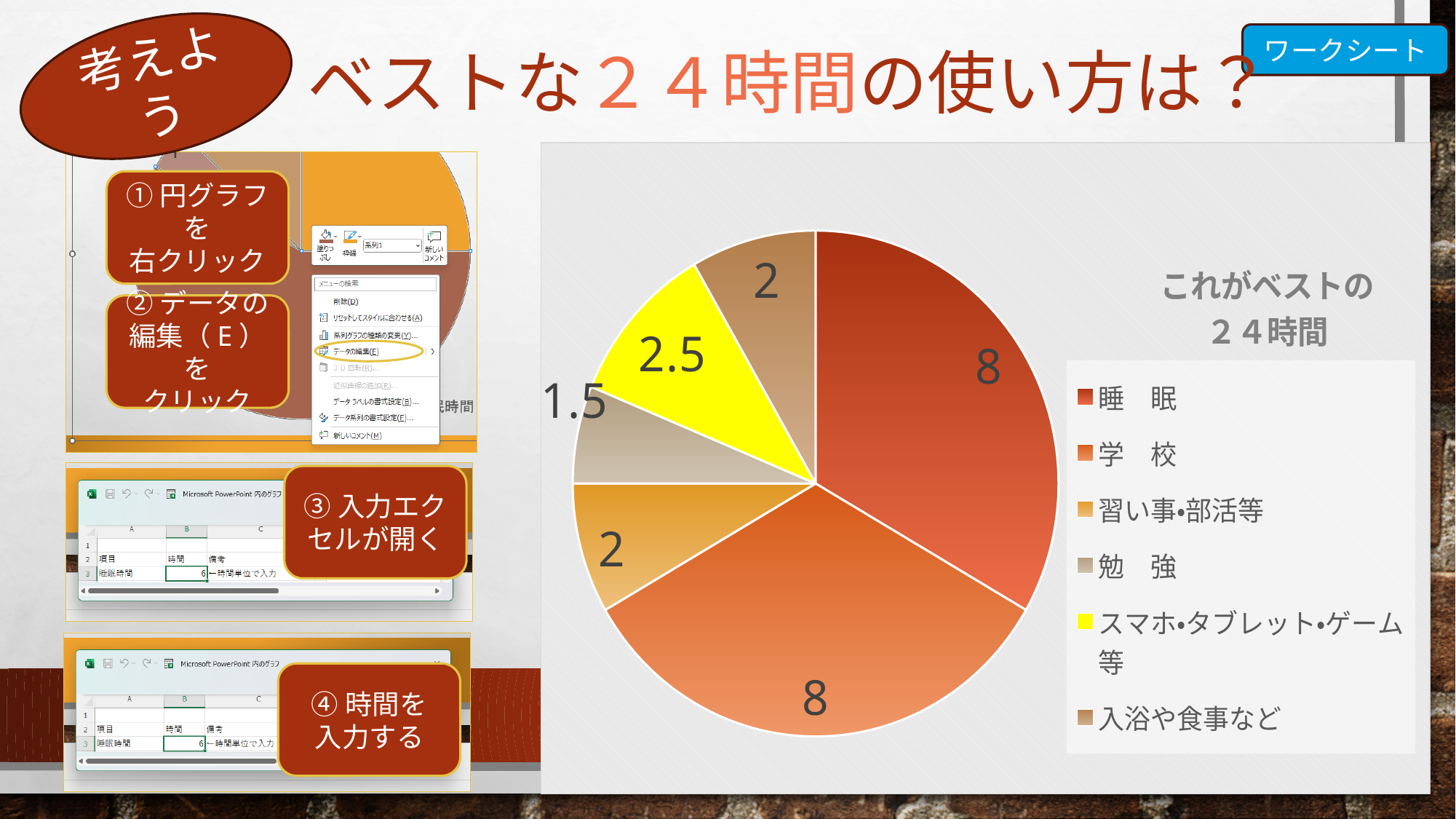
What is the total of all the values shown in the pie chart? 24 Which is larger in the pie chart, スマホ・タブレット・ゲーム等 or 勉強? スマホ・タブレット・ゲーム等 What is the difference between the values for 睡眠 and スマホ・タブレット・ゲーム等 in the pie chart? 5.5 What is the value for 入浴や食事など in the pie chart? 2 What colour is the slice for スマホ・タブレット・ゲーム等 in the pie chart? Yellow What kind of chart is shown on the right side of the slide? Pie chart What is the value for スマホ・タブレット・ゲーム等 in the pie chart? 2.5 What is the value for 睡眠 in the pie chart? 8 Which category has the smallest slice in the pie chart? 勉強 What is the value for 学校 in the pie chart? 8 How many categories does the pie chart legend list? 6 What is the value for 勉強 in the pie chart? 1.5